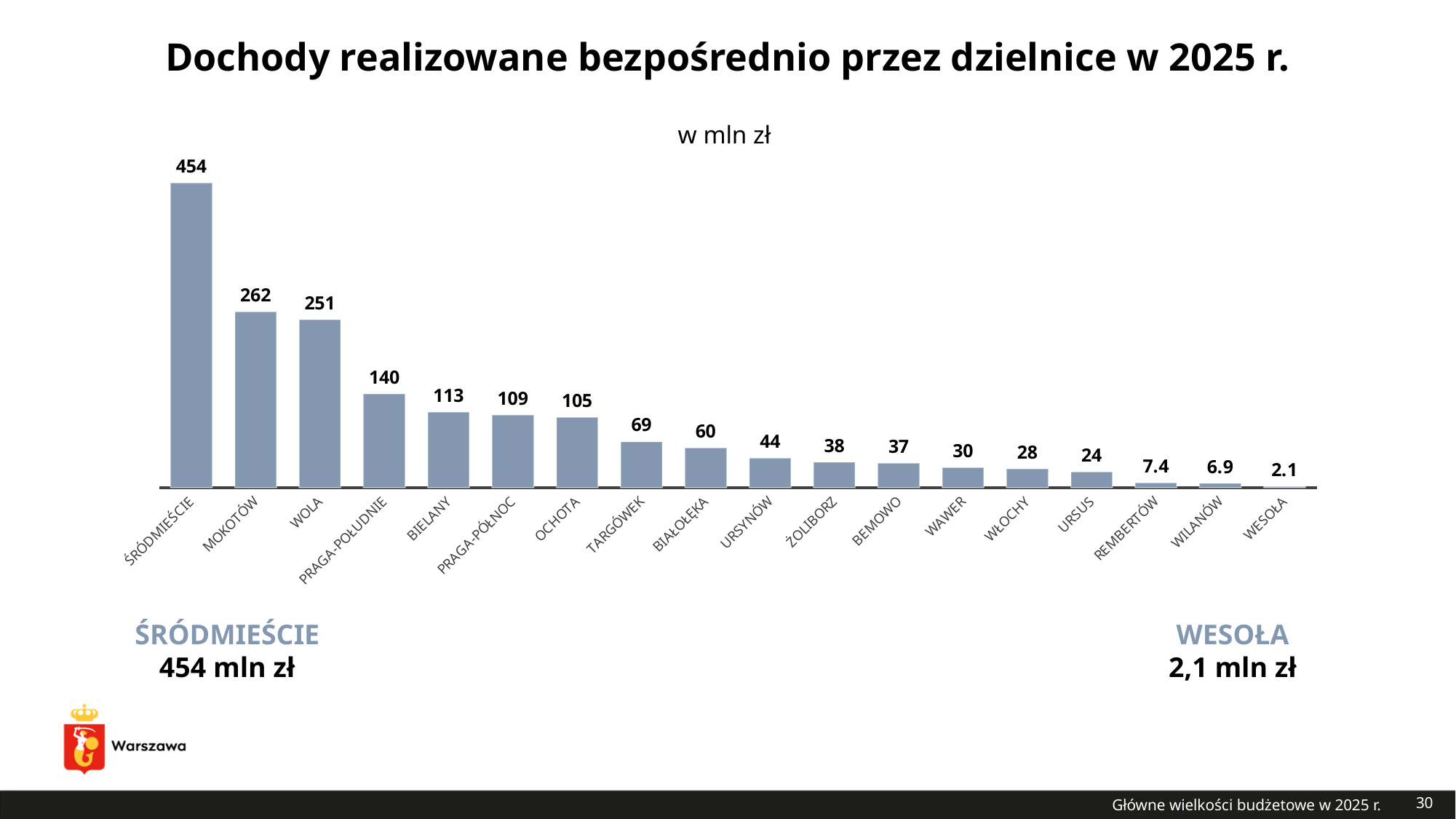
Which district has the lowest value? WESOŁA Which has a larger value, WOLA or PRAGA-POŁUDNIE? WOLA How many districts are shown in the chart? 18 What is the value for PRAGA-POŁUDNIE? 140 What is the value for MOKOTÓW? 262 What is the difference between the values for ŚRÓDMIEŚCIE and MOKOTÓW? 192 What kind of chart is shown on the slide? bar chart Which has a larger value, URSUS or WŁOCHY? WŁOCHY Do the values rise or fall from left to right along the x axis? fall Which district has the highest value? ŚRÓDMIEŚCIE What is the value for REMBERTÓW? 7.4 What is the difference between the values for BIELANY and OCHOTA? 8